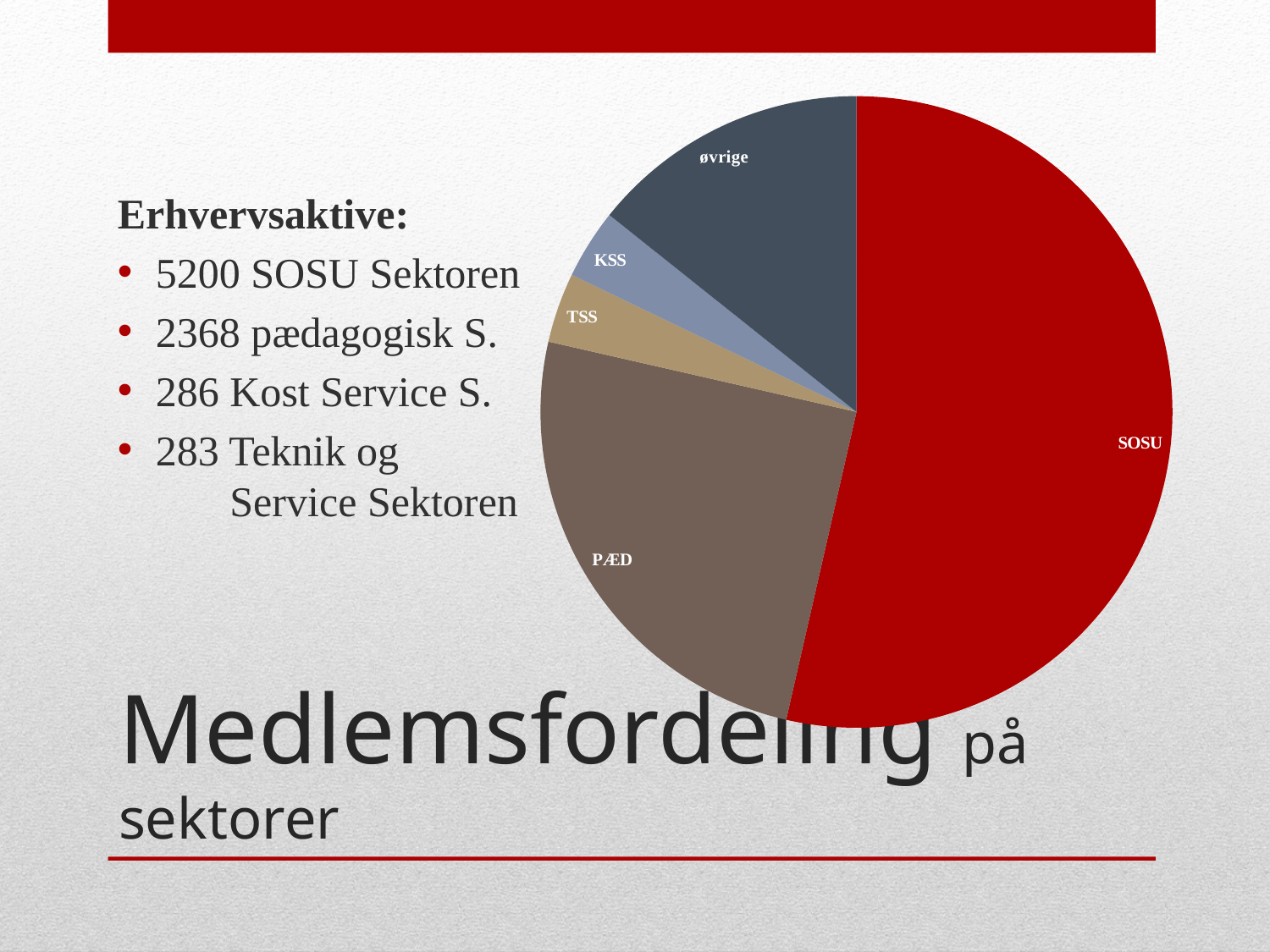
Which slice is larger, SOSU or PÆD? SOSU According to the slide text, how many members are in the SOSU Sektoren? 5200 Which slice is the second largest in the pie chart? PÆD What colour is the SOSU slice? red What kind of chart is shown on the slide? pie chart Does the SOSU slice take up more or less than half of the pie? more What is the title of the slide containing the pie chart? Medlemsfordeling på sektorer Which slice is larger, PÆD or øvrige? PÆD According to the slide text, how many members are in the pædagogisk sector? 2368 Which sector has the largest slice in the pie chart? SOSU Which slice is larger, øvrige or TSS? øvrige How many slices does the pie chart have? 5